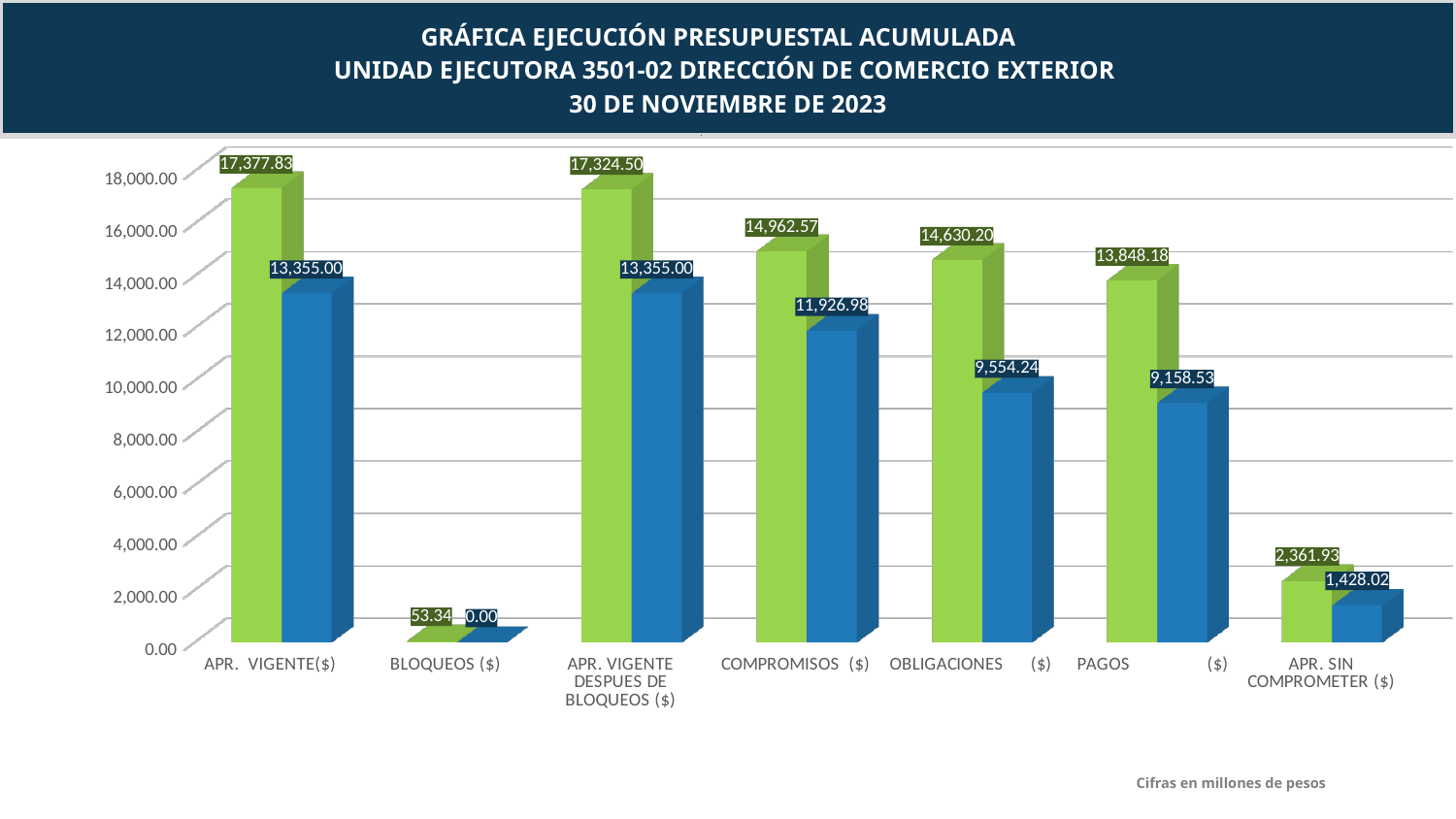
What is the value of the green bar for PAGOS ($)? 13,848.18 Which is larger, the blue bar for COMPROMISOS ($) or the blue bar for PAGOS ($)? COMPROMISOS ($) What is the value of the blue bar for OBLIGACIONES ($)? 9,554.24 What is the difference between the green bars for APR. VIGENTE($) and APR. VIGENTE DESPUES DE BLOQUEOS ($)? 53.33 What is the value of the blue bar for BLOQUEOS ($)? 0.00 How many categories are shown on the x axis? 7 What kind of chart is shown on the slide? Bar chart What is the difference between the green and blue bars for PAGOS ($)? 4,689.65 Which category has the lowest blue bar? BLOQUEOS ($) Which category has the highest green bar? APR. VIGENTE($) What unit note is printed at the bottom right of the slide? Cifras en millones de pesos What is the value of the green bar for COMPROMISOS ($)? 14,962.57